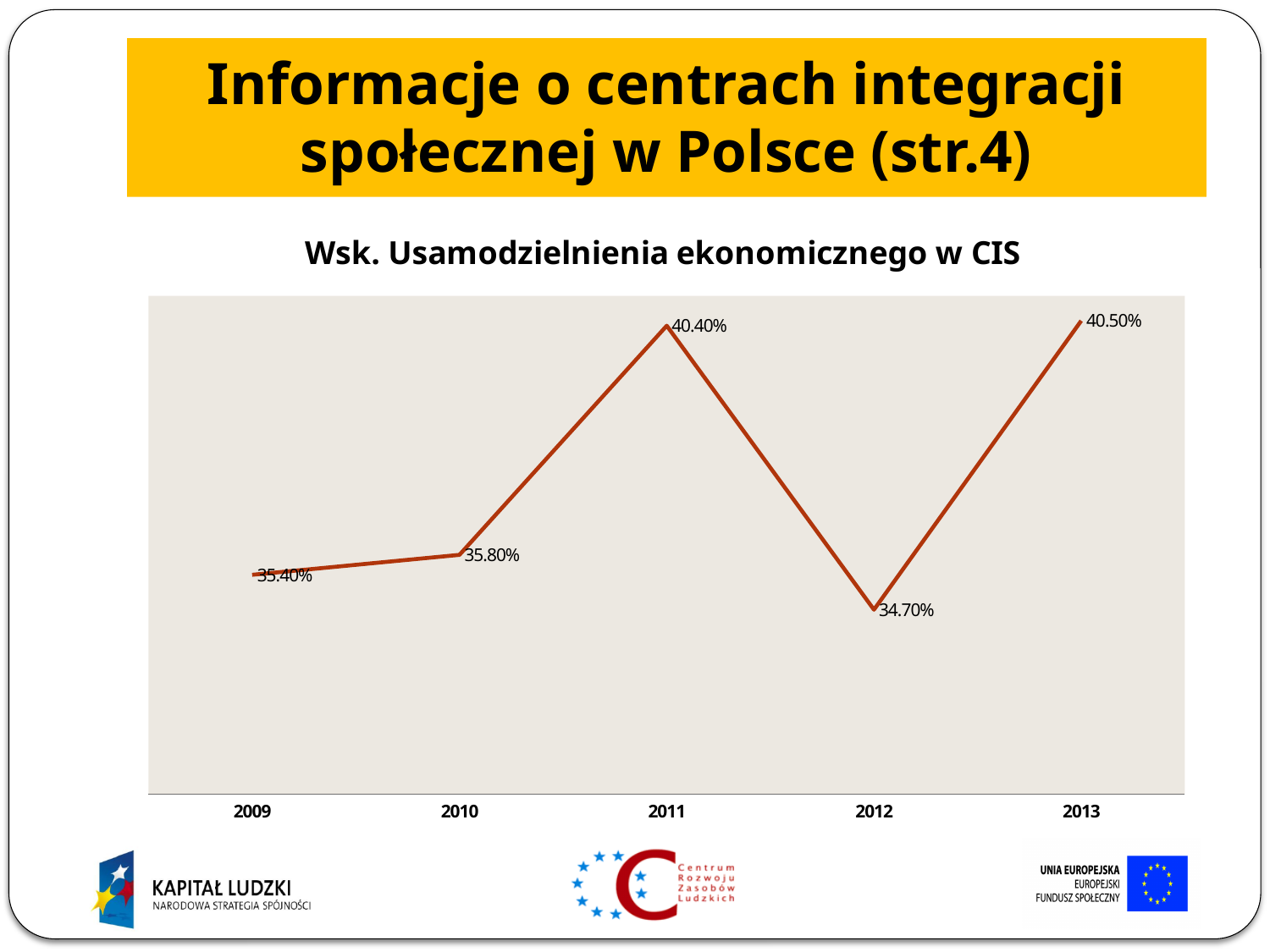
What is the title of the chart? Wsk. Usamodzielnienia ekonomicznego w CIS What is the value for 2012? 34.70% Which is larger, the value for 2010 or the value for 2012? 2010 What kind of chart is shown? line chart Which year has the lowest value? 2012 What is the difference between the values for 2010 and 2009? 0.40% How many years are plotted on the x axis? 5 Does the value rise or fall from 2011 to 2012? fall What is the difference between the values for 2011 and 2012? 5.70% Which year has the highest value? 2013 What is the value for 2009? 35.40% What is the value for 2011? 40.40%